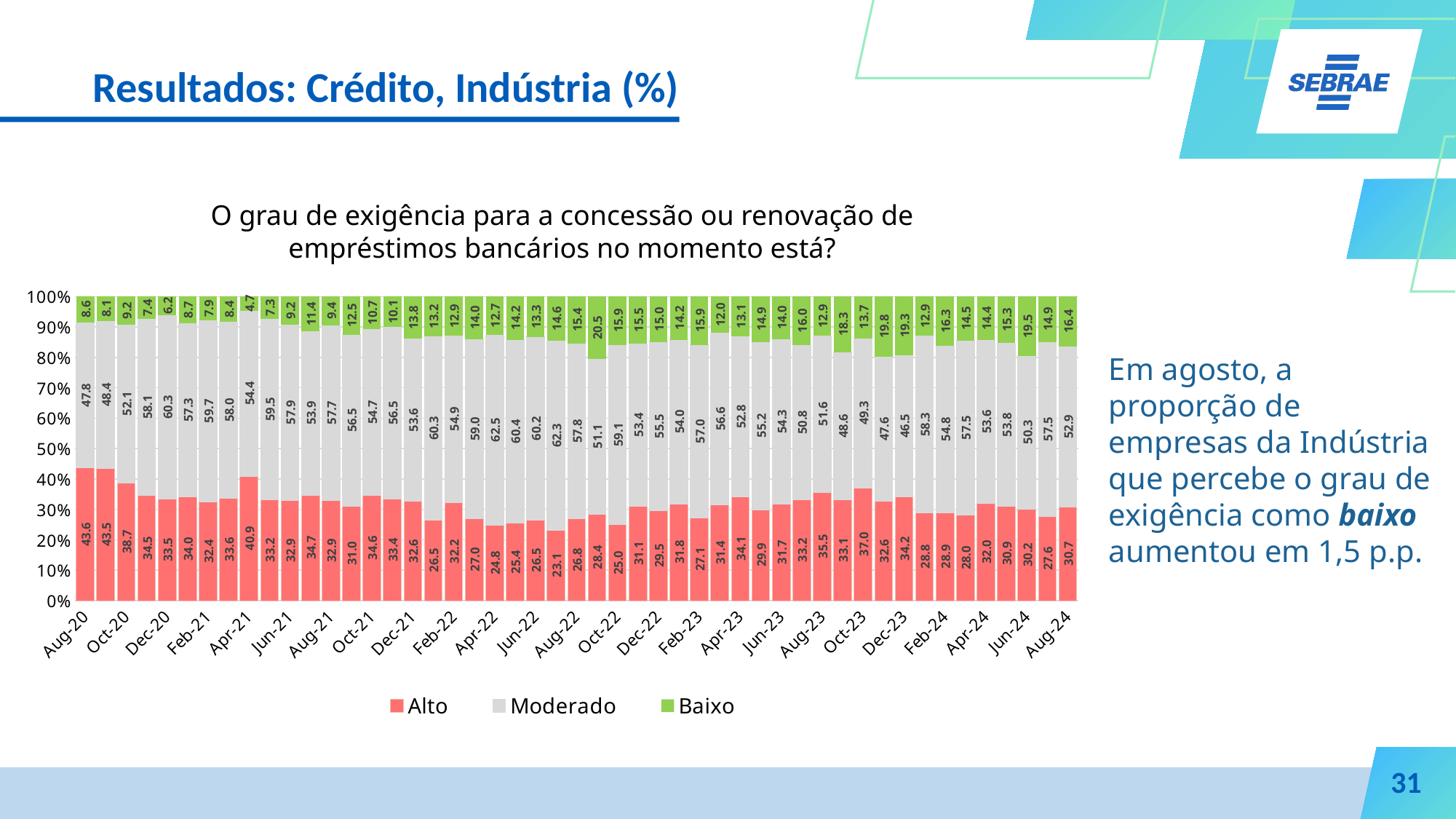
In which month is the Baixo value lowest? Apr-21 What is the value for Baixo in Aug-24? 16.4 What is the value for Alto in Aug-20? 43.6 How many series does the legend list? 3 What is the value for Alto in Aug-24? 30.7 What is the difference between the Alto values in Aug-20 and Aug-24? 12.9 What is the difference between the Baixo values in Jun-24 and Aug-24? 3.1 Which is larger, the Baixo value in Jun-24 or in Aug-24? Jun-24 What is the value for Moderado in Apr-22? 62.5 What type of chart is shown on the slide? stacked bar chart What is the value for Moderado in Dec-23? 46.5 Which series is shown in green in the legend? Baixo